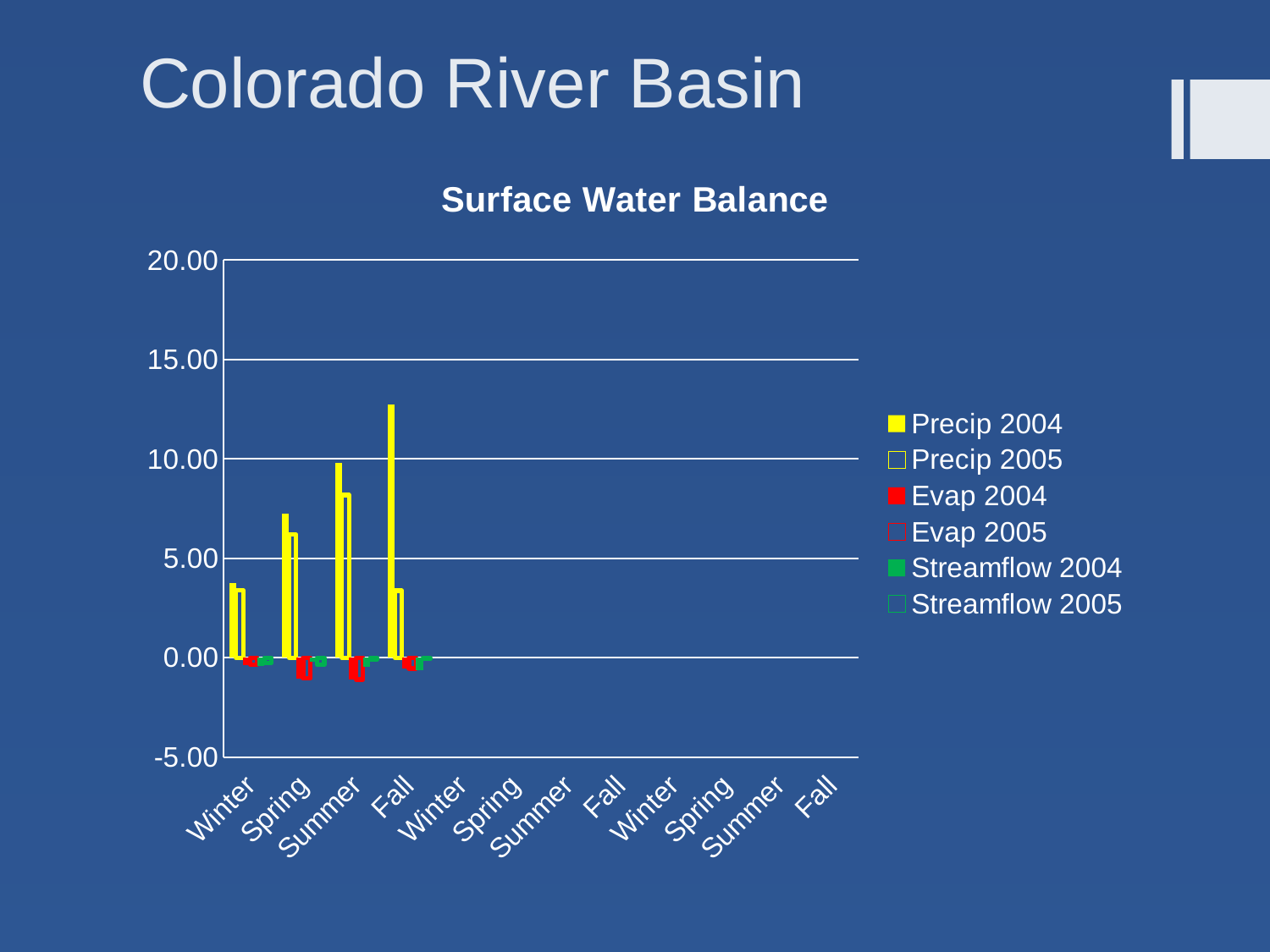
How many series does the legend list? 6 In which season is the Precip 2004 bar highest? Fall What colour represents Precip 2004 in the legend? yellow How many category labels are shown along the x axis? 12 Do the Precip 2004 bars rise or fall from Winter to Fall in the first group of seasons? rise Which is larger for Fall: Precip 2004 or Precip 2005? Precip 2004 Is the Precip 2005 value for Summer greater or less than 5.00? greater Is the Precip 2004 value for Winter greater or less than 5.00? less In which season is the Precip 2004 bar lowest? Winter Is the Precip 2004 value for Fall greater or less than 10.00? greater What is the title of the chart? Surface Water Balance What kind of chart is shown on the slide? bar chart